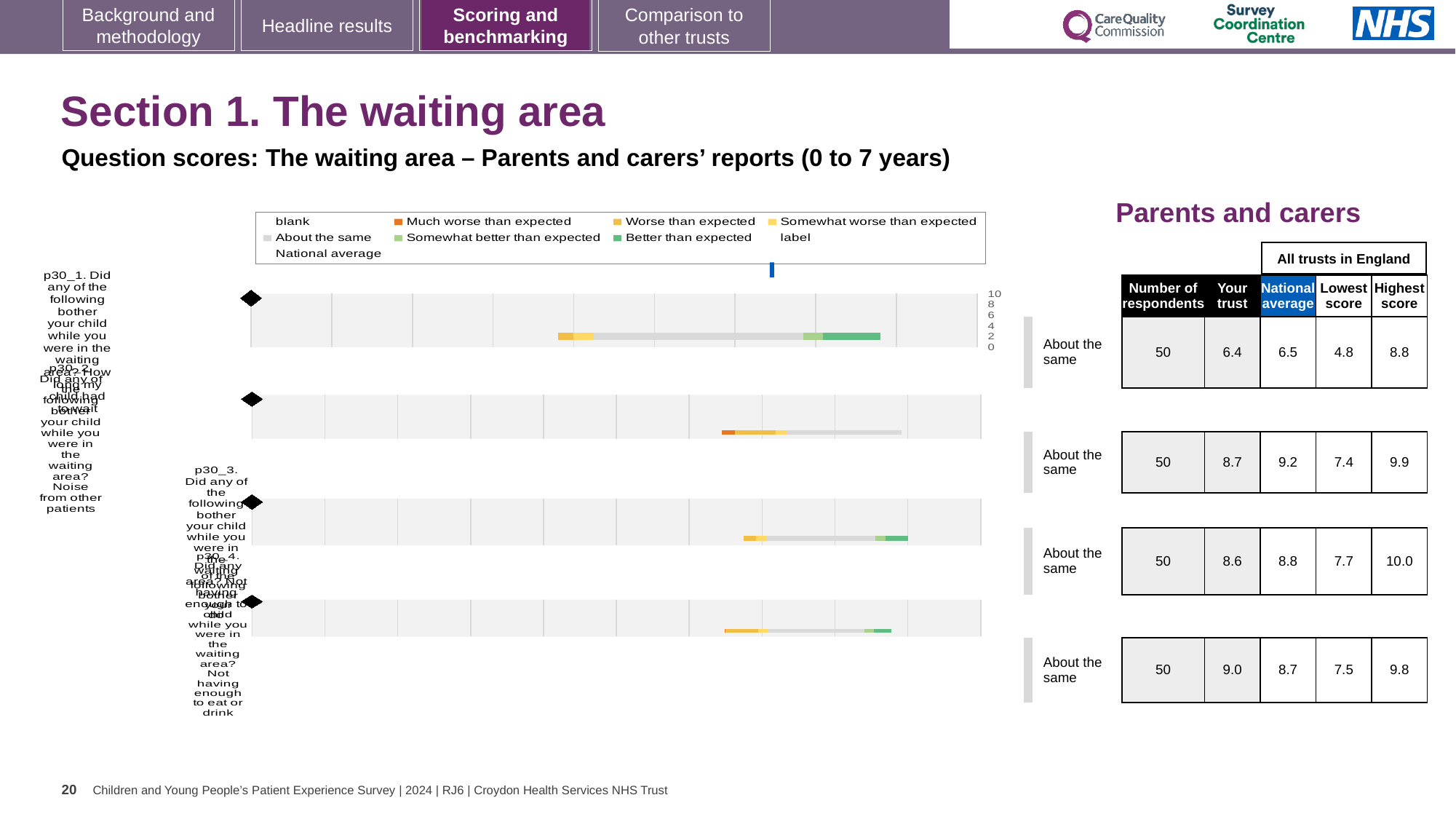
What kind of chart is used to show the question scores for the waiting area? bar chart How many entries does the chart legend list? 9 In the table beside the charts, how many respondents are listed for p30_1? 50 In the table beside the charts, which question has the lowest 'Your trust' score? p30_1 (6.4) In the table beside the charts, which question has the highest 'Your trust' score? p30_4 (9.0) How many separate question charts (p30_1 to p30_4) are shown on the slide? 4 In the table beside the charts, for p30_4 is the 'Your trust' score or the 'National average' larger? Your trust In the table beside the charts, what is the difference between the National average and Your trust score for p30_2? 0.5 What colour represents 'Much worse than expected' in the chart legend? orange In the table beside the charts, what is the Highest score for p30_3? 10.0 What is the subtitle above the charts? Question scores: The waiting area – Parents and carers’ reports (0 to 7 years) In the table beside the charts, what is the 'Your trust' score for p30_4 (Not having enough to eat or drink)? 9.0